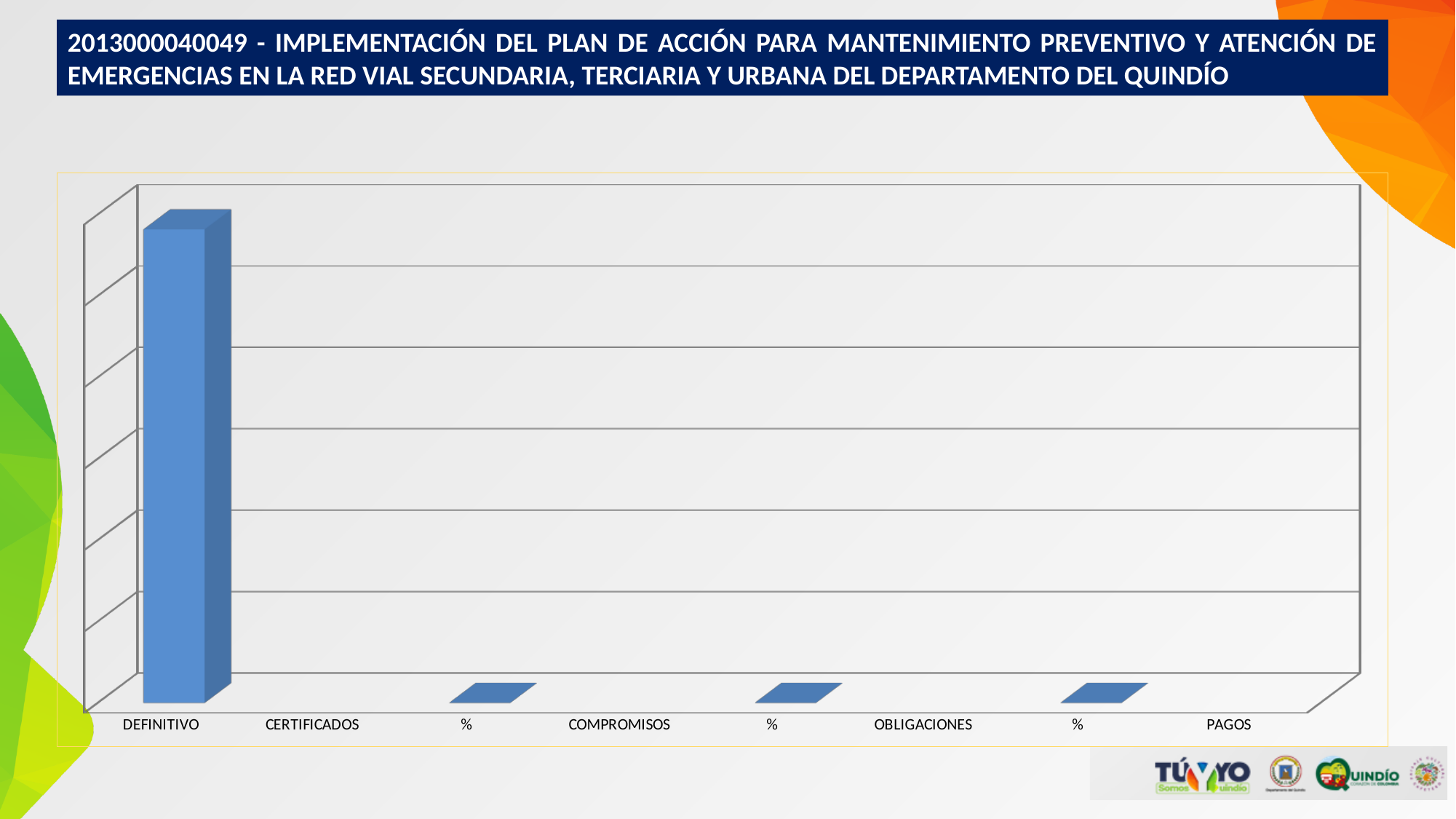
Which is larger, the bar for DEFINITIVO or the bar for PAGOS? DEFINITIVO Which is larger, the bar for DEFINITIVO or the bar for CERTIFICADOS? DEFINITIVO How many categories are shown along the x axis of the chart? 8 Which category has the tallest bar in the chart? DEFINITIVO What is the label of the last category on the x axis? PAGOS What is the label of the first category on the x axis? DEFINITIVO What kind of chart is shown on the slide? bar chart